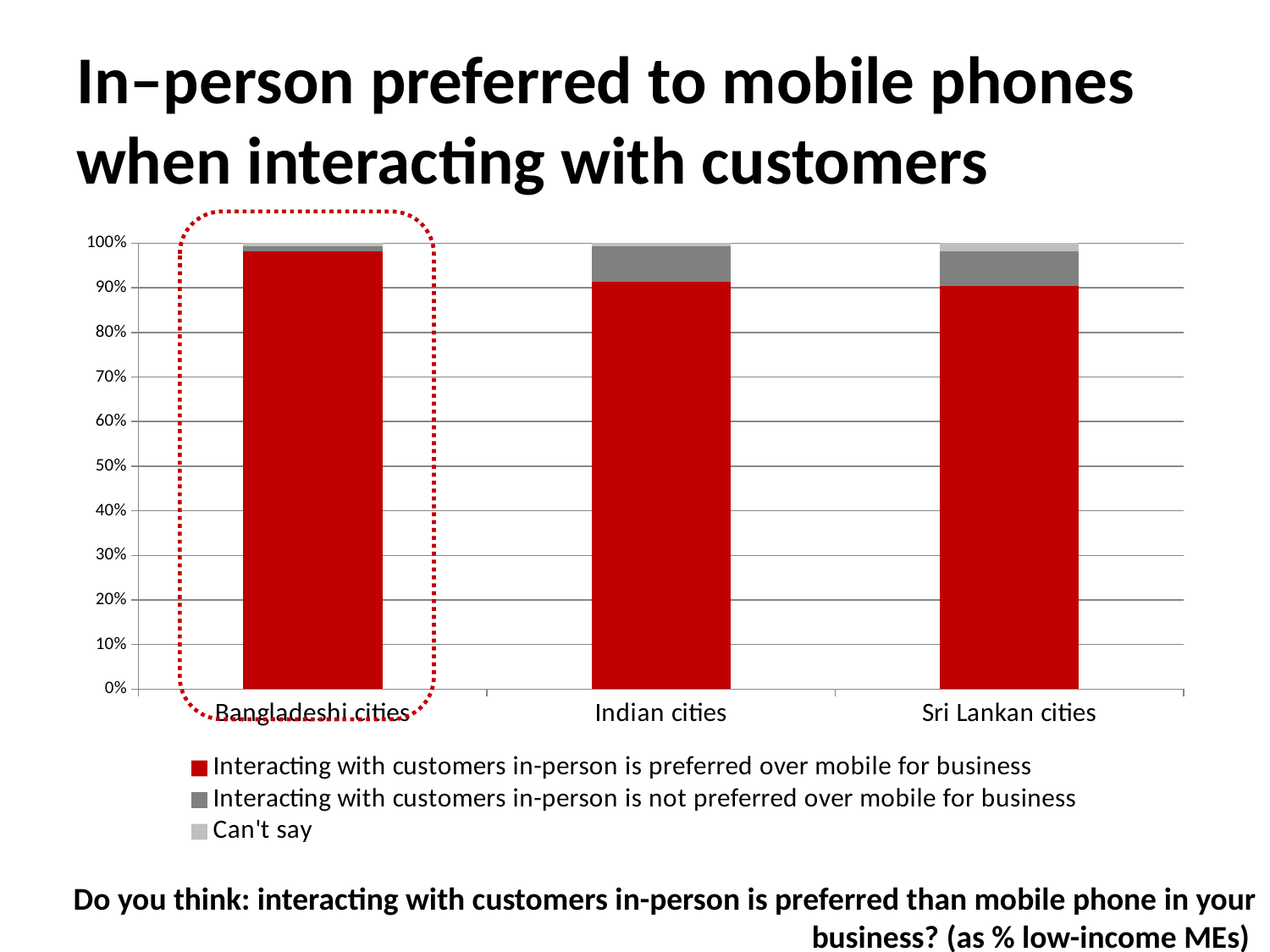
Is the value for 'Interacting with customers in-person is not preferred over mobile for business' in Indian cities greater or less than 20%? less Which is larger: the 'preferred over mobile' share in Bangladeshi cities or in Indian cities? Bangladeshi cities How many series does the legend list? 3 Is the value for 'Interacting with customers in-person is preferred over mobile for business' in Indian cities greater or less than 80%? greater Which city group has the highest share for 'Interacting with customers in-person is preferred over mobile for business'? Bangladeshi cities What colour represents 'Interacting with customers in-person is preferred over mobile for business' in the chart? Red What kind of chart is shown on the slide? Stacked bar chart Is the value for 'Interacting with customers in-person is preferred over mobile for business' in Bangladeshi cities greater or less than 90%? greater What is the label of the third category on the x axis? Sri Lankan cities How many city groups (categories) are shown on the x axis? 3 Which city group is highlighted with a dotted red outline on the chart? Bangladeshi cities